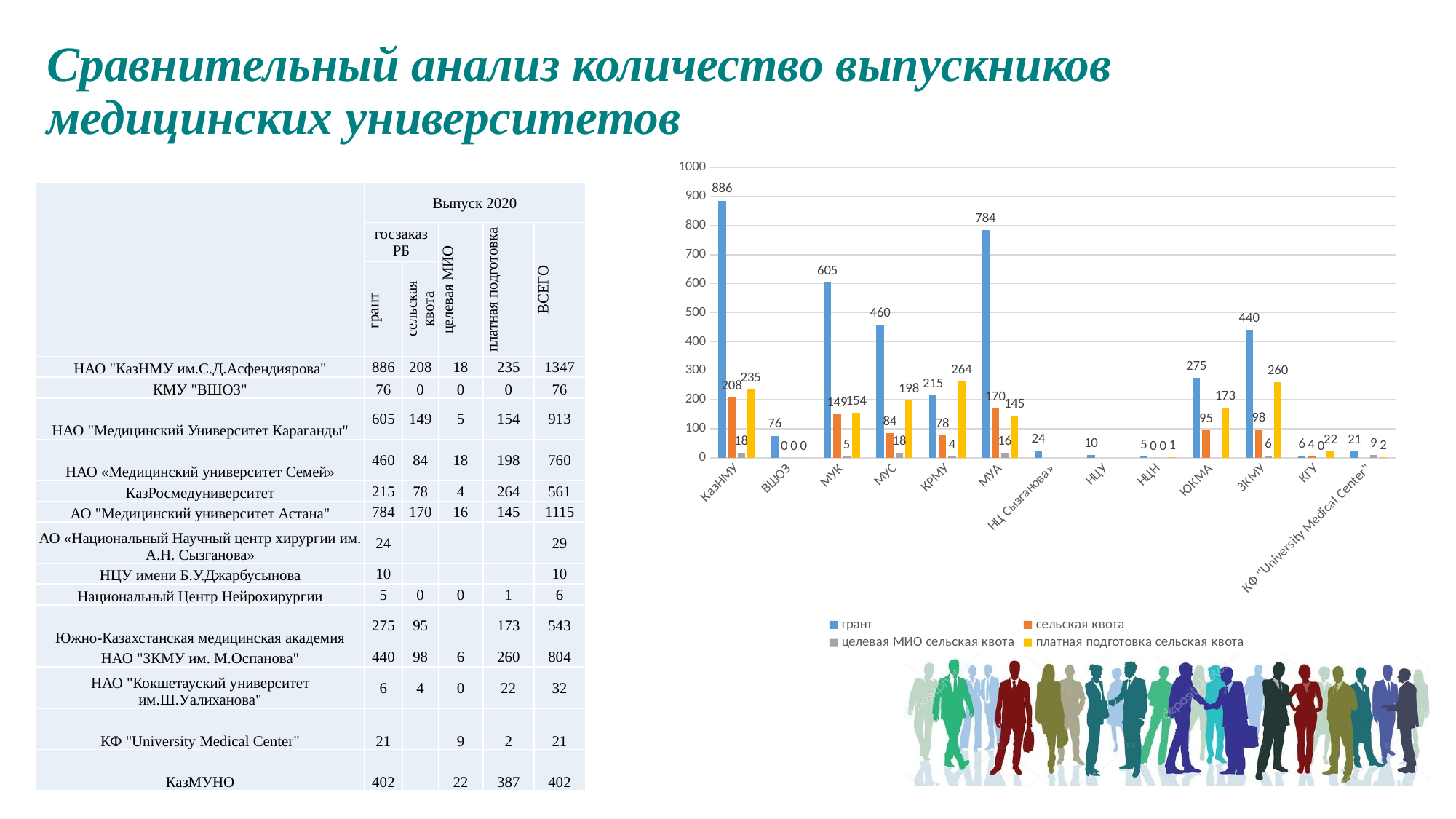
Which is larger in the chart: the грант value for ЗКМУ or the грант value for ЮКМА? ЗКМУ What is the difference between the грант values for МУК and МУС in the chart? 145 How many categories are shown on the x axis of the chart? 13 What is the платная подготовка value for ЗКМУ in the chart? 260 What is the сельская квота value for МУА in the chart? 170 Which category has the highest грант value in the chart? КазНМУ Which series in the chart is shown in blue? грант What is the difference between the грант and сельская квота values for КазНМУ in the chart? 678 What kind of chart is shown on the slide? bar chart What is the грант value for КазНМУ in the chart? 886 What is the платная подготовка value for КРМУ in the chart? 264 How many series does the chart legend list? 4